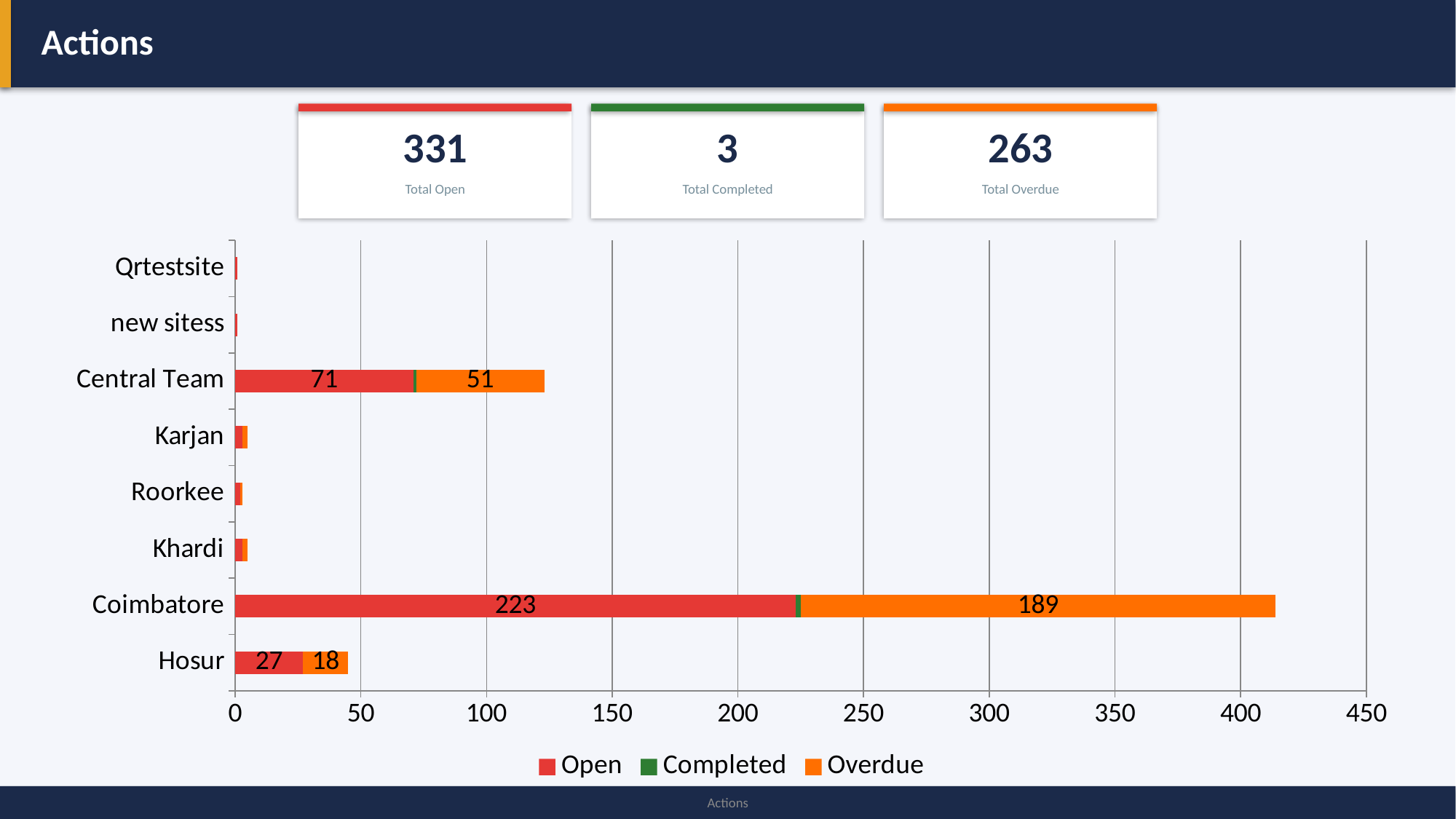
What type of chart is shown on the slide? bar chart What is the Overdue value for Central Team? 51 What is the difference between the Open and Overdue values for Coimbatore? 34 What is the difference between the Open values for Central Team and Hosur? 44 Which category has the highest Open value? Coimbatore How many series does the chart legend list? 3 What is the Open value for Coimbatore? 223 How many categories are shown on the chart's vertical axis? 8 Which series is shown in orange in the legend? Overdue Which is larger, the Overdue value for Central Team or the Overdue value for Hosur? Central Team What is the Overdue value for Hosur? 18 Is the total length of the Coimbatore bar greater or less than 400? greater